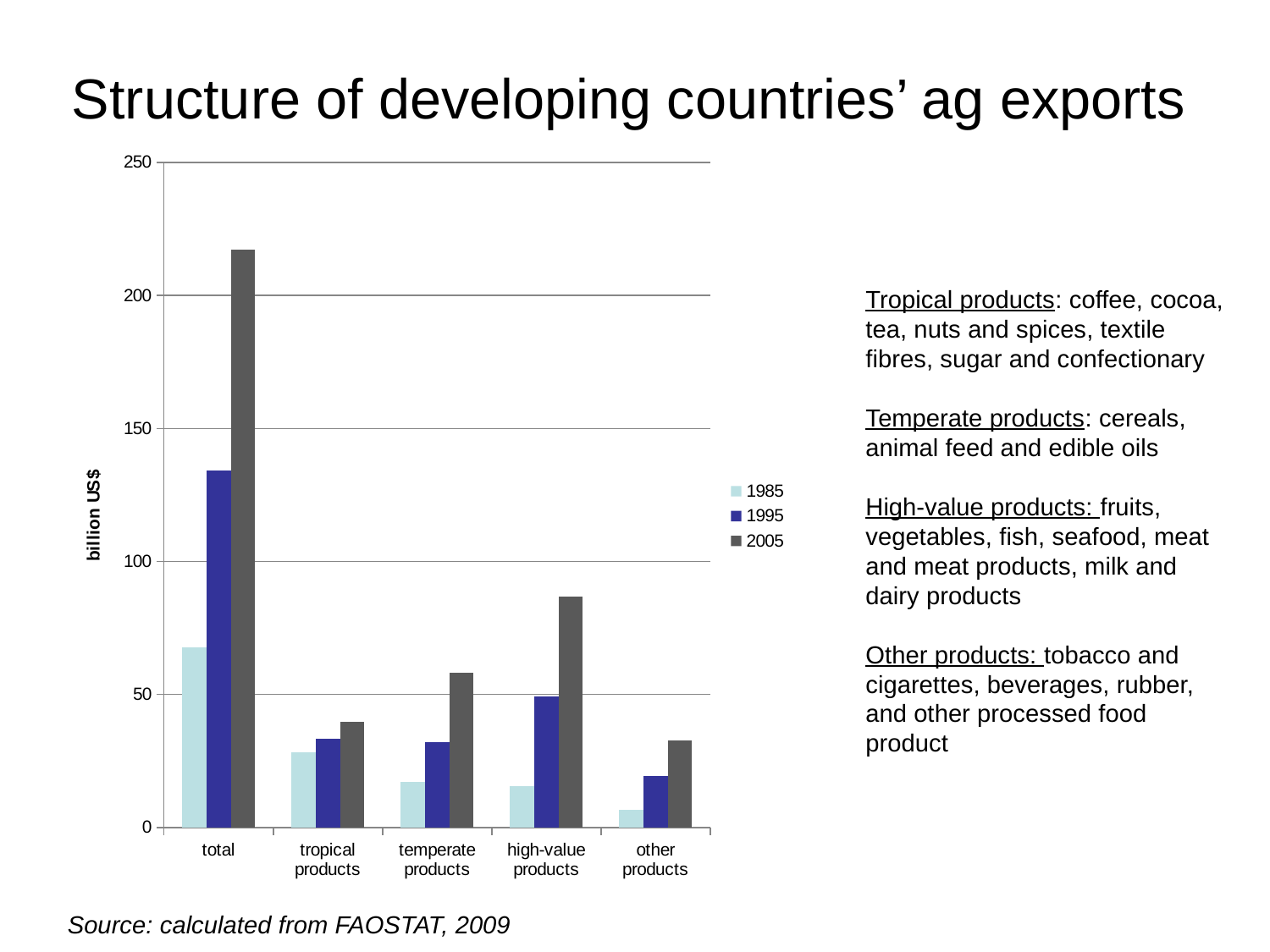
How many series does the legend list? 3 Is the 2005 value for high-value products greater or less than 50? greater What kind of chart is shown on the slide? bar chart How many categories are shown on the x axis? 5 Which category has the lowest 1985 value? other products What is the label on the vertical axis? billion US$ Which is larger, the 1985 value for tropical products or the 1985 value for temperate products? tropical products Is the 2005 value for tropical products greater or less than 50? less Is the 2005 value for total greater or less than 200? greater Excluding total, which category has the highest 2005 value? high-value products For high-value products, do the values rise or fall from 1985 to 2005? rise